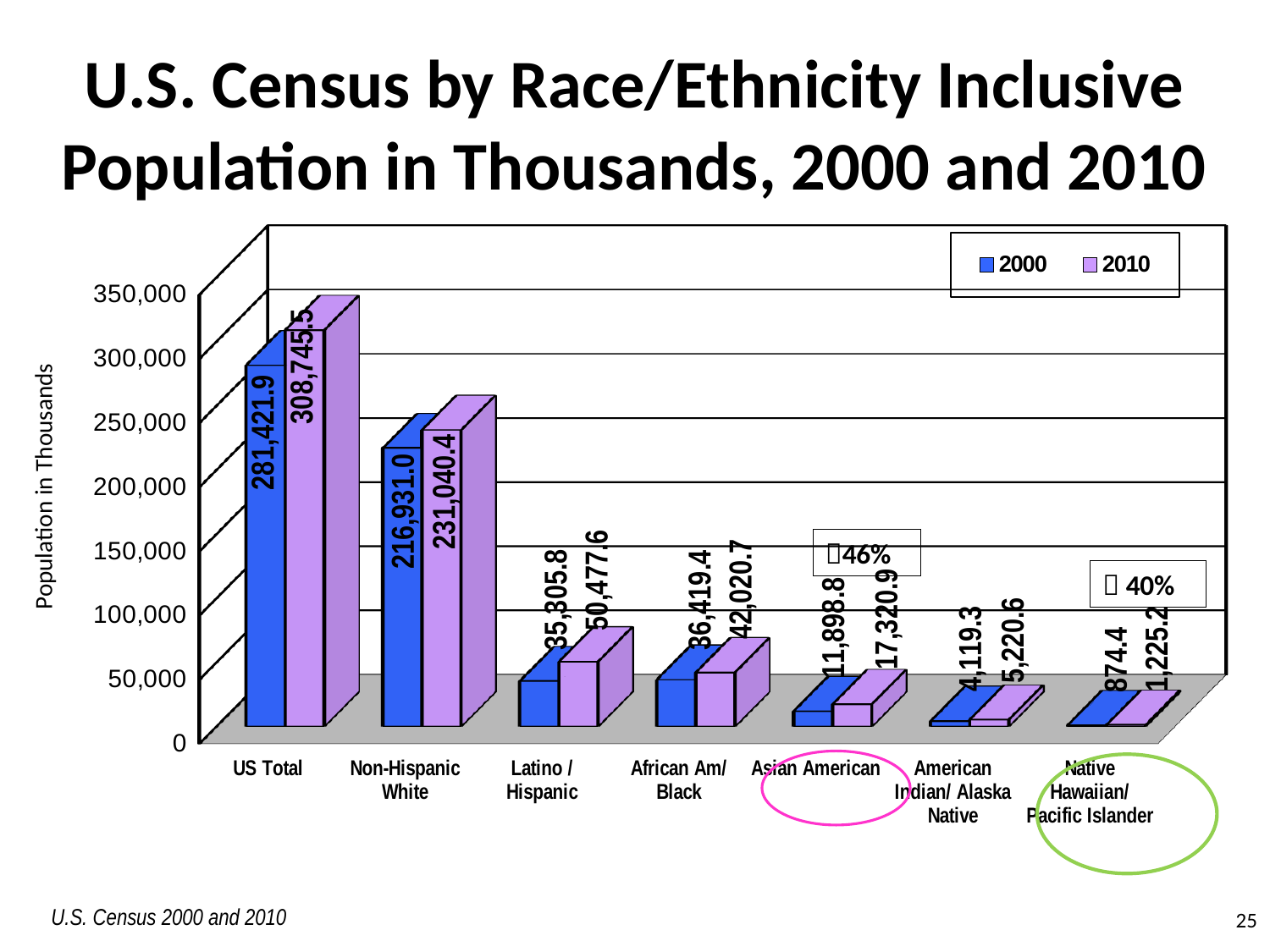
What is the 2000 value for Non-Hispanic White? 216,931.0 How many series does the legend list? 2 What is the 2010 value for Latino / Hispanic? 50,477.6 What is the difference between the 2010 and 2000 values for US Total? 27,323.6 Which is larger, the 2000 value for Latino / Hispanic or the 2000 value for African Am/ Black? African Am/ Black What is the 2000 value for Native Hawaiian/ Pacific Islander? 874.4 What is the label of the y axis? Population in Thousands Excluding US Total, which category has the lowest 2010 value? Native Hawaiian/ Pacific Islander What is the difference between the 2010 and 2000 values for Asian American? 5,422.1 What kind of chart is shown on the slide? bar chart What is the 2010 value for US Total? 308,745.5 How many race/ethnicity categories are shown on the x axis? 7